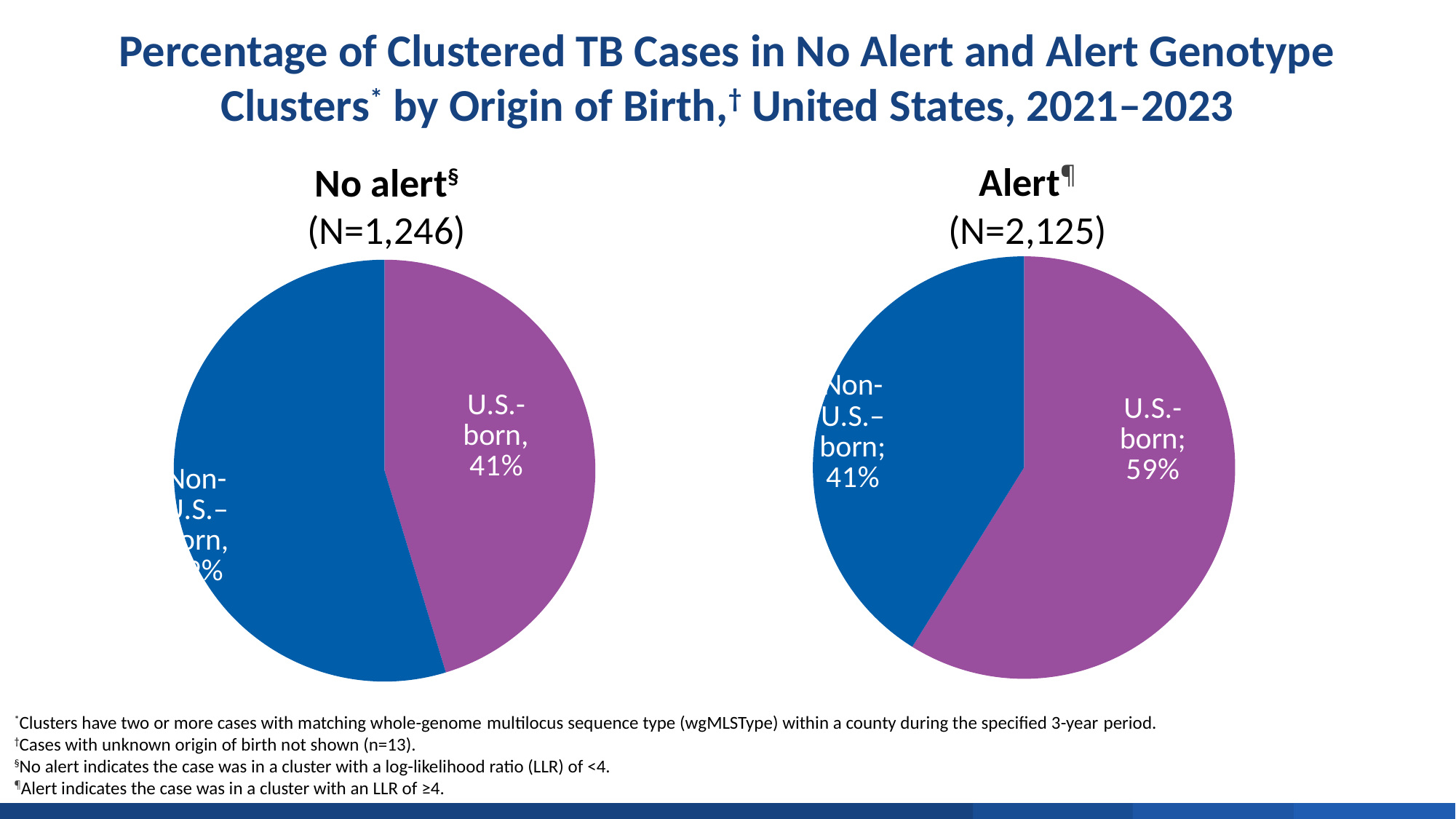
In the Alert pie chart, what percentage of clustered TB cases were Non-U.S.-born? 41% What type of chart is used on this slide? Pie chart In the No alert pie chart, which origin-of-birth group has the larger share? Non-U.S.-born What is the total number of cases (N) shown for the Alert pie chart? 2,125 In the Alert pie chart, what percentage of clustered TB cases were U.S.-born? 59% What is the total number of cases (N) shown for the No alert pie chart? 1,246 In the Alert pie chart, which group has the smaller share? Non-U.S.-born Is the U.S.-born share larger in the No alert pie chart or the Alert pie chart? Alert In the Alert pie chart, what is the difference in percentage points between the U.S.-born and Non-U.S.-born shares? 18 How many slices does the Alert pie chart have? 2 In the No alert pie chart, what percentage of clustered TB cases were U.S.-born? 41% In the Alert pie chart, which origin-of-birth group has the larger share? U.S.-born